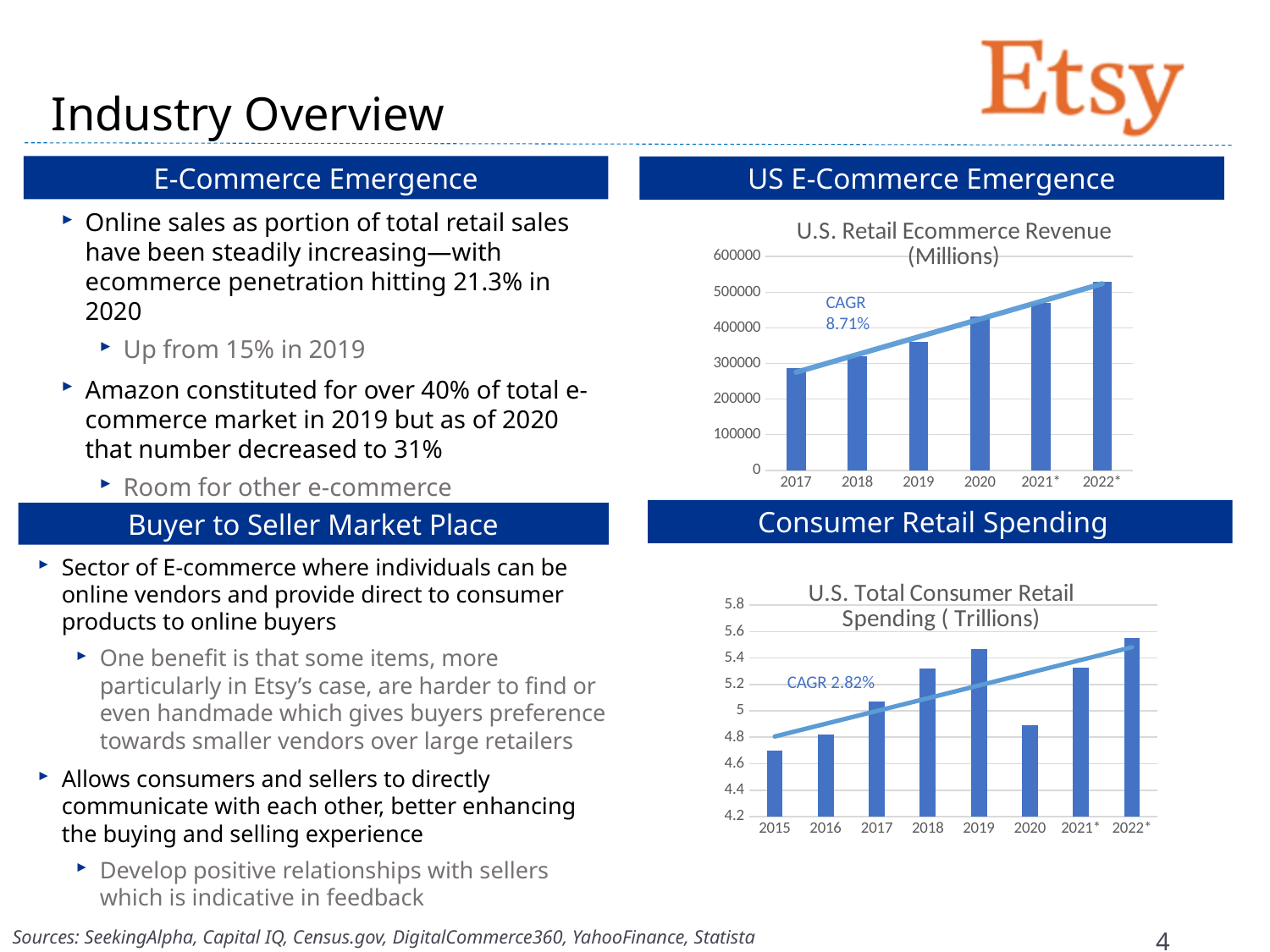
In the U.S. Retail Ecommerce Revenue chart, how many years are shown on the x axis? 6 What type of chart is the U.S. Retail Ecommerce Revenue chart? bar chart In the U.S. Total Consumer Retail Spending chart, how many years are shown on the x axis? 8 In the U.S. Total Consumer Retail Spending chart, which year has the lowest bar? 2015 In the U.S. Retail Ecommerce Revenue chart, which year has the lowest bar? 2017 In the U.S. Total Consumer Retail Spending chart, is the value for 2020 greater or less than 5? less In the U.S. Retail Ecommerce Revenue chart, is the value for 2017 greater or less than 300000? less What CAGR is annotated on the U.S. Retail Ecommerce Revenue chart? 8.71% In the U.S. Retail Ecommerce Revenue chart, which year has the highest bar? 2022* In the U.S. Retail Ecommerce Revenue chart, is the value for 2022* greater or less than 500000? greater In the U.S. Retail Ecommerce Revenue chart, do the values rise or fall from 2017 to 2022*? rise In the U.S. Total Consumer Retail Spending chart, which is larger, the value for 2019 or the value for 2020? 2019